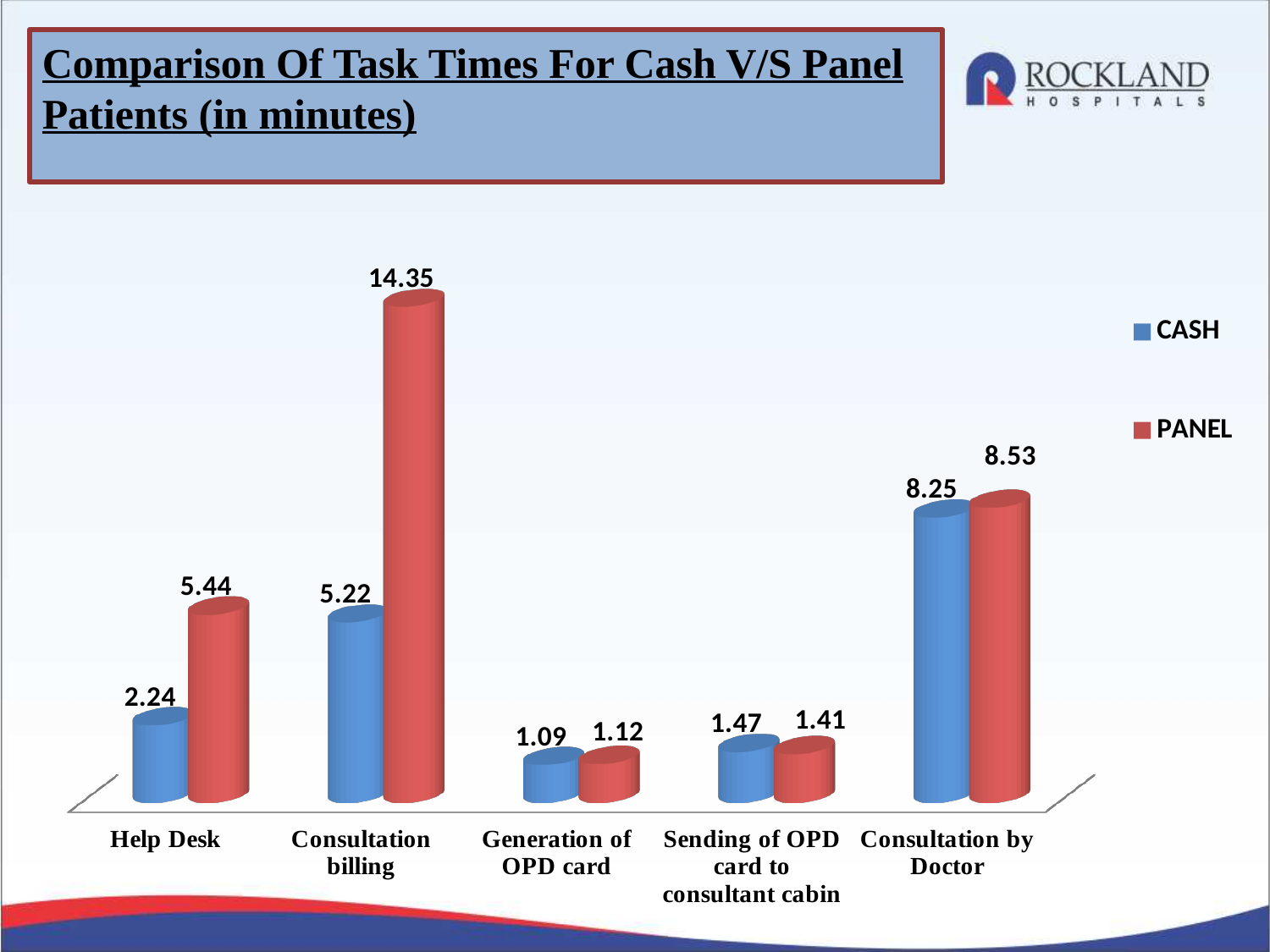
How many series does the legend list? 2 How many tasks are shown on the x axis? 5 What is the CASH task time for Help Desk? 2.24 What is the CASH task time for Consultation by Doctor? 8.25 What kind of chart is shown on the slide? Bar chart Which task has the lowest CASH time? Generation of OPD card What is the difference between the PANEL and CASH times for Help Desk? 3.20 What is the PANEL task time for Consultation billing? 14.35 What is the PANEL task time for Sending of OPD card to consultant cabin? 1.41 What is the difference between the PANEL and CASH times for Consultation billing? 9.13 Which is larger for Consultation by Doctor, the CASH time or the PANEL time? PANEL Which task has the highest PANEL time? Consultation billing